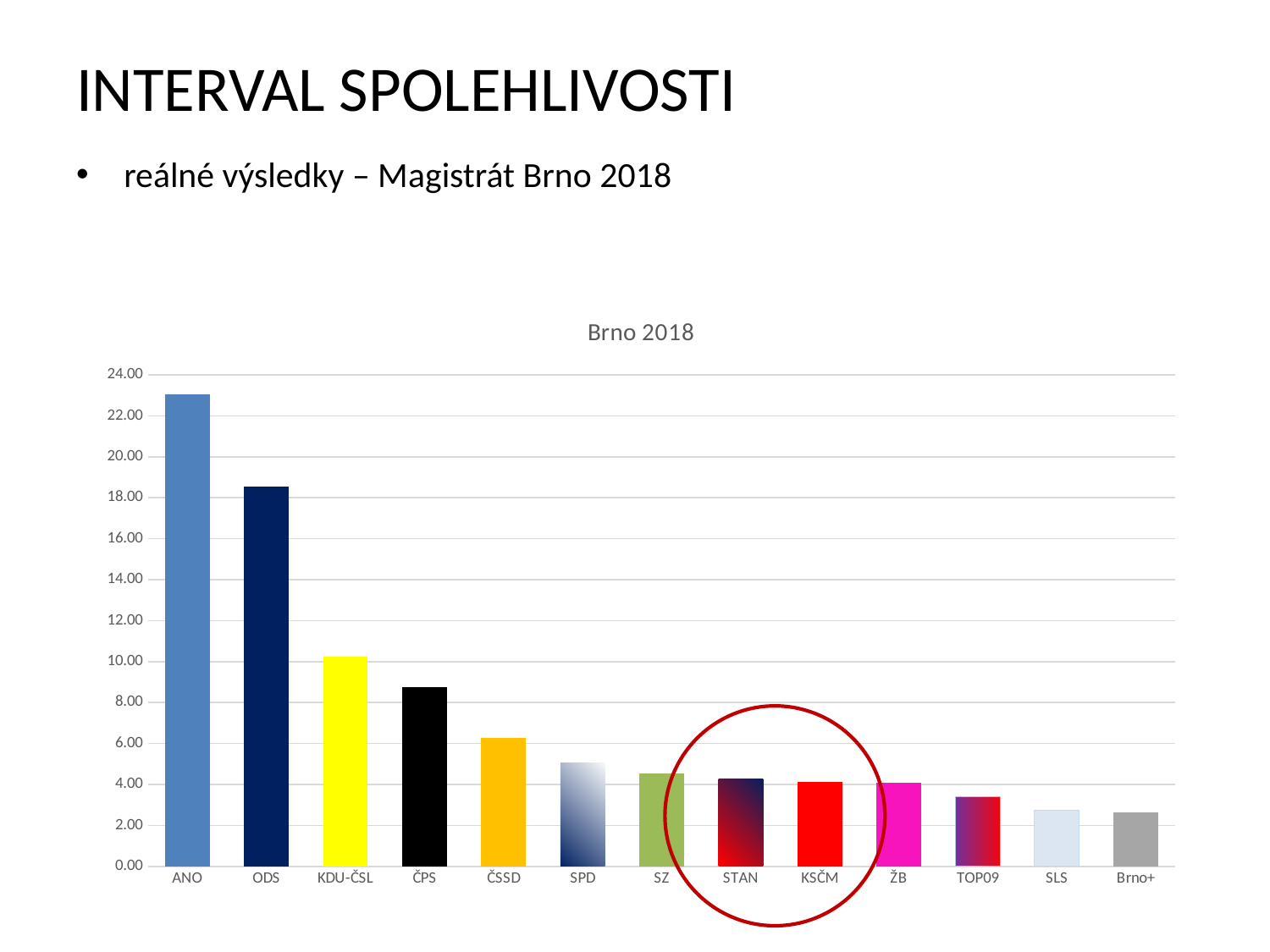
How many parties (categories) are shown on the x axis of the chart? 13 Is the value for KDU-ČSL greater or less than 8.00? greater What kind of chart is shown on the slide? bar chart Which two parties' bars are highlighted with a red circle on the chart? STAN and KSČM Is the value for TOP09 greater or less than 4.00? less Which party has the highest value in the chart? ANO Is the value for ODS greater or less than 20.00? less Do the values generally rise or fall moving from left to right along the x axis? fall Which has a larger value, ODS or KDU-ČSL? ODS What is the title of the chart? Brno 2018